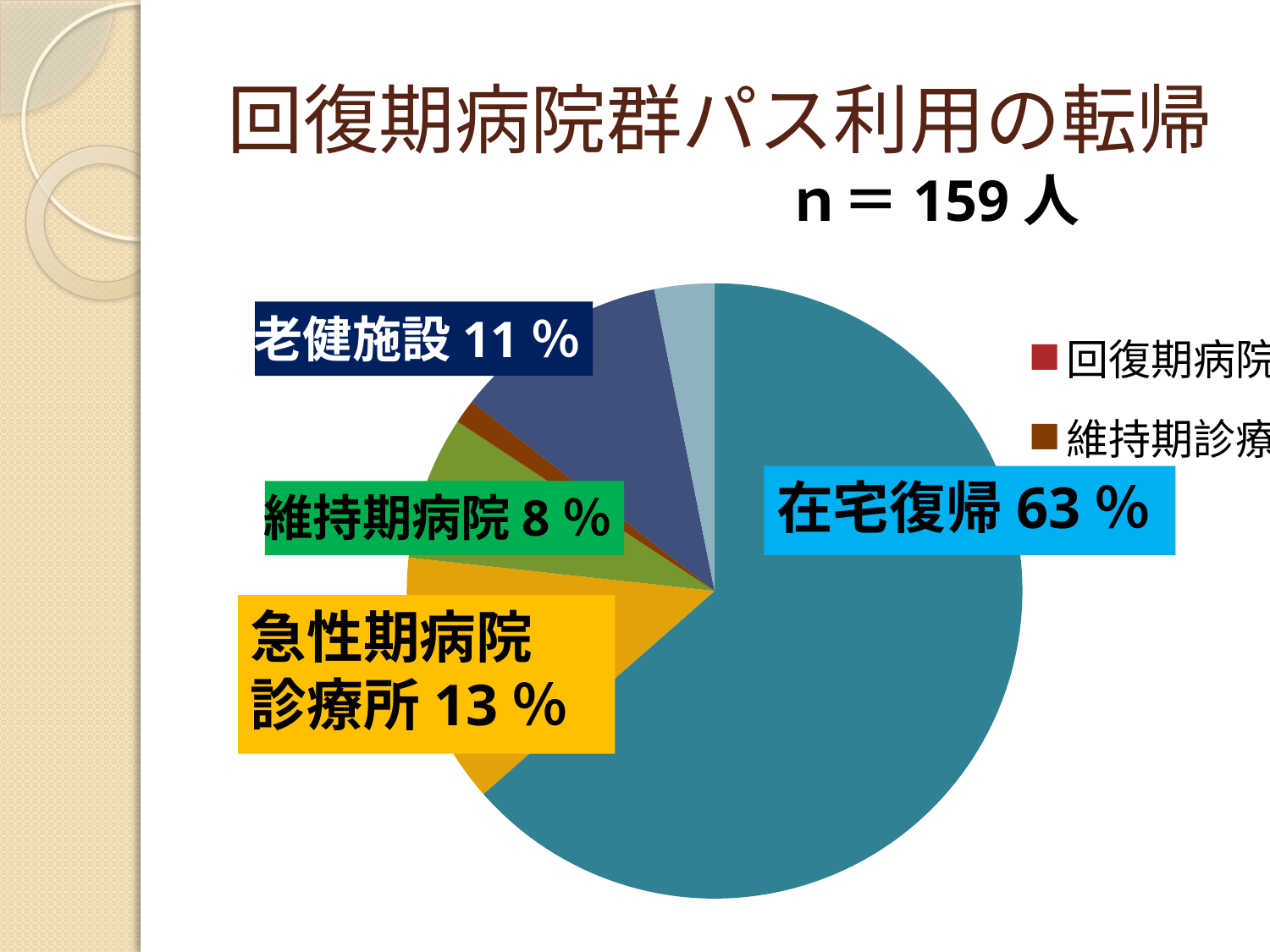
How many percentage points larger is 老健施設 than 維持期病院? 3% What sample size (n) is stated on the slide? n = 159 人 Which category has the largest share of the pie chart? 在宅復帰 What percentage is shown for 急性期病院診療所? 13% What percentage is shown for 老健施設? 11% What percentage of the pie chart is labelled 在宅復帰? 63% What is the title of the chart on the slide? 回復期病院群パス利用の転帰 Which has a larger share, 急性期病院診療所 or 老健施設? 急性期病院診療所 How many percentage points larger is 在宅復帰 than 急性期病院診療所? 50% Which has a larger share, 老健施設 or 維持期病院? 老健施設 What kind of chart is shown on the slide? Pie chart What percentage is shown for 維持期病院? 8%